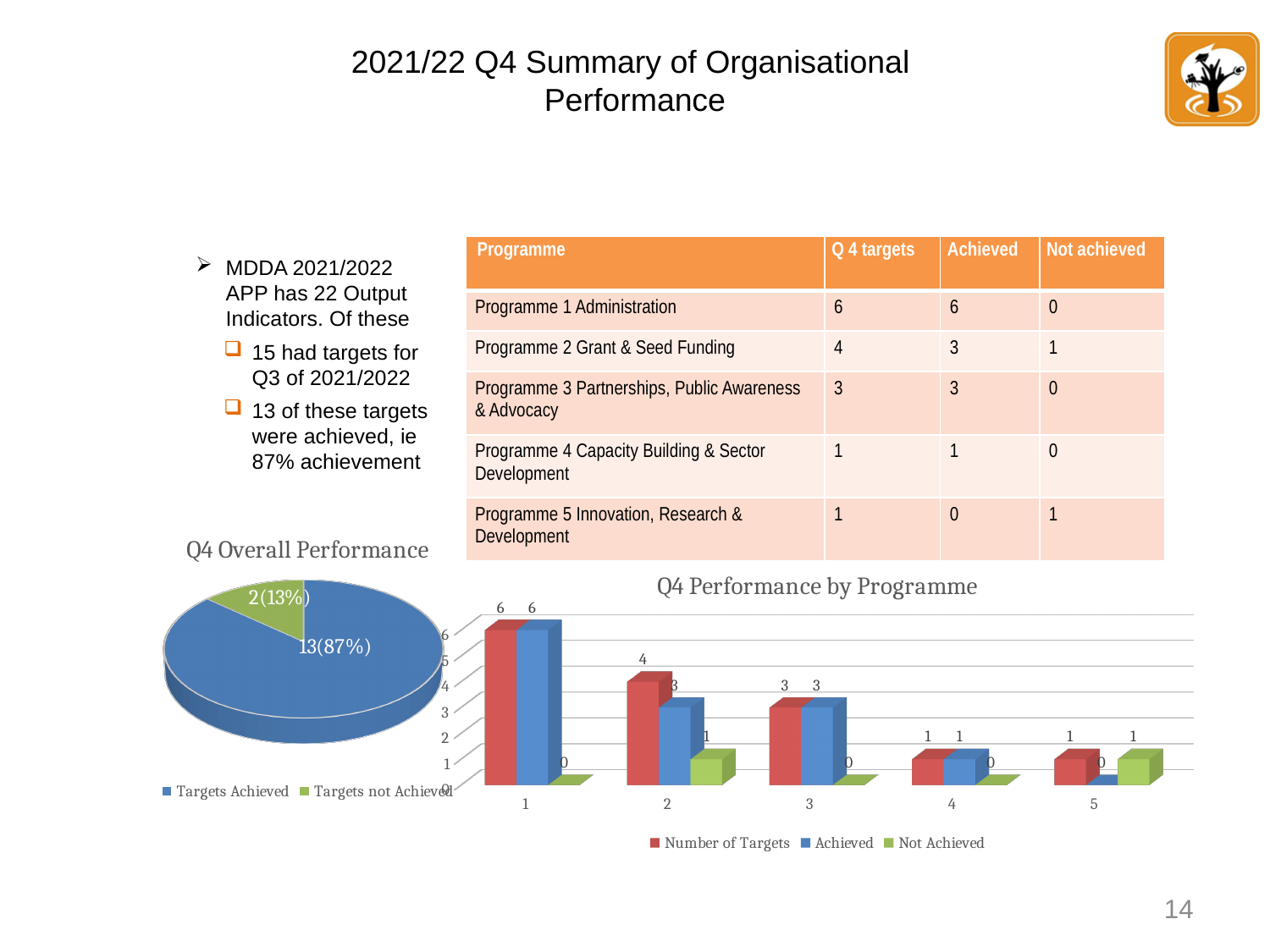
In the 'Q4 Overall Performance' pie chart, what share of the pie is 'Targets not Achieved'? 13% In the 'Q4 Performance by Programme' chart, which has the larger 'Achieved' value, category 1 or category 3? category 1 In the 'Q4 Overall Performance' pie chart, what is the value for 'Targets Achieved'? 13(87%) How many entries does the legend of the 'Q4 Overall Performance' pie chart list? 2 In the 'Q4 Performance by Programme' chart, what is the 'Number of Targets' value for category 2? 4 What kind of chart is the 'Q4 Overall Performance' chart? pie chart In the 'Q4 Performance by Programme' chart, what is the difference between 'Number of Targets' and 'Achieved' for category 2? 1 How many series does the legend of the 'Q4 Performance by Programme' chart list? 3 How many categories are shown on the x axis of the 'Q4 Performance by Programme' chart? 5 In the 'Q4 Performance by Programme' chart, what is the 'Not Achieved' value for category 5? 1 In the 'Q4 Performance by Programme' chart, which category has the highest 'Number of Targets' value? 1 What kind of chart is the 'Q4 Performance by Programme' chart? bar chart